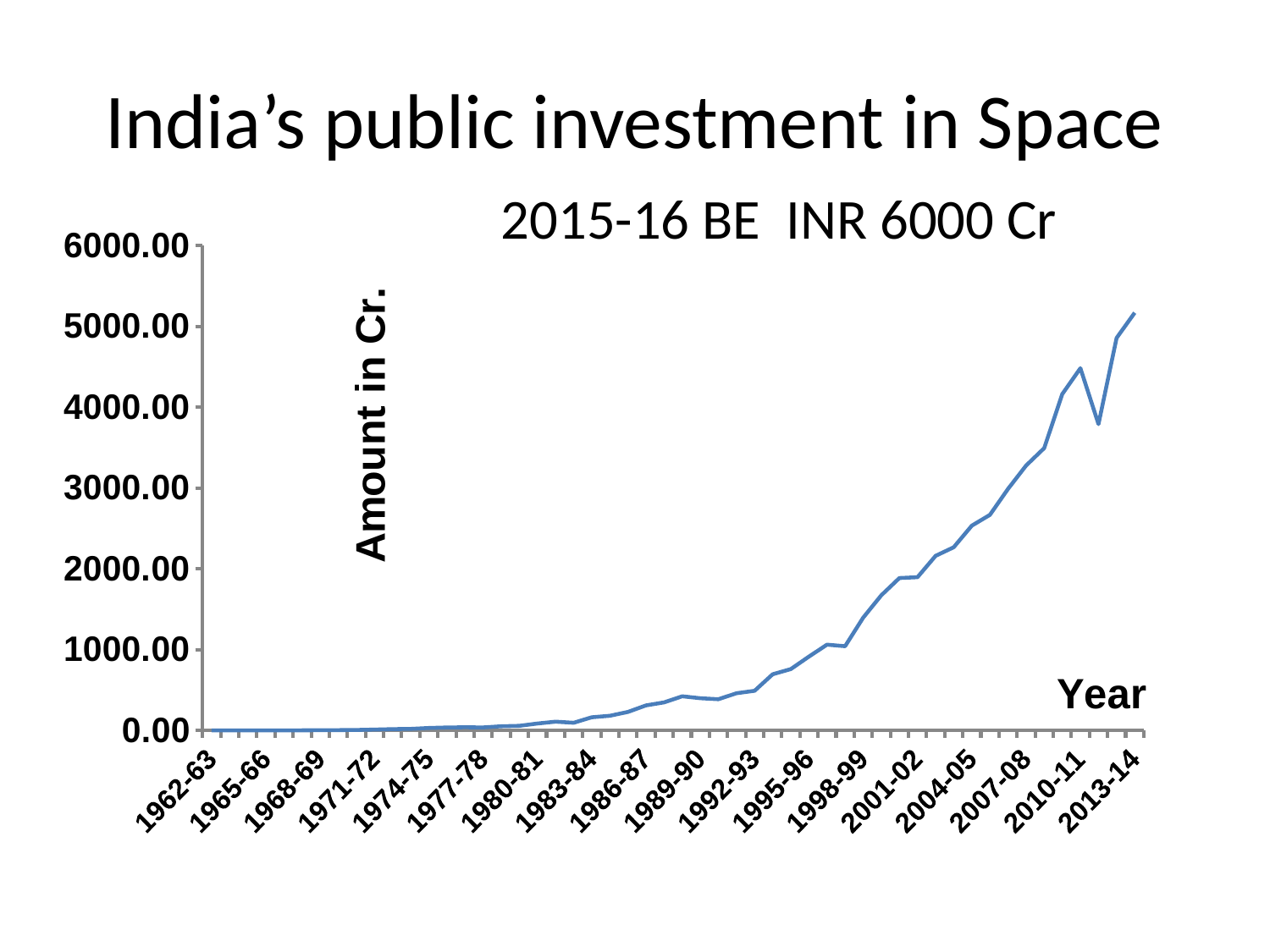
What kind of chart is shown on the slide? line chart What budget estimate for 2015-16 is stated above the chart? INR 6000 Cr What is the title of the vertical axis? Amount in Cr. Which is larger, the value for 1986-87 or the value for 2001-02? 2001-02 Which year on the x axis has the highest investment value? 2013-14 Does India's public investment in space generally rise or fall from 1962-63 to 2013-14? rise Is the value for 2013-14 greater or less than 4000.00? greater Is the value for 1989-90 greater or less than 1000.00? less How many data series are plotted on the chart? 1 Is the value for 2007-08 greater or less than 2000.00? greater